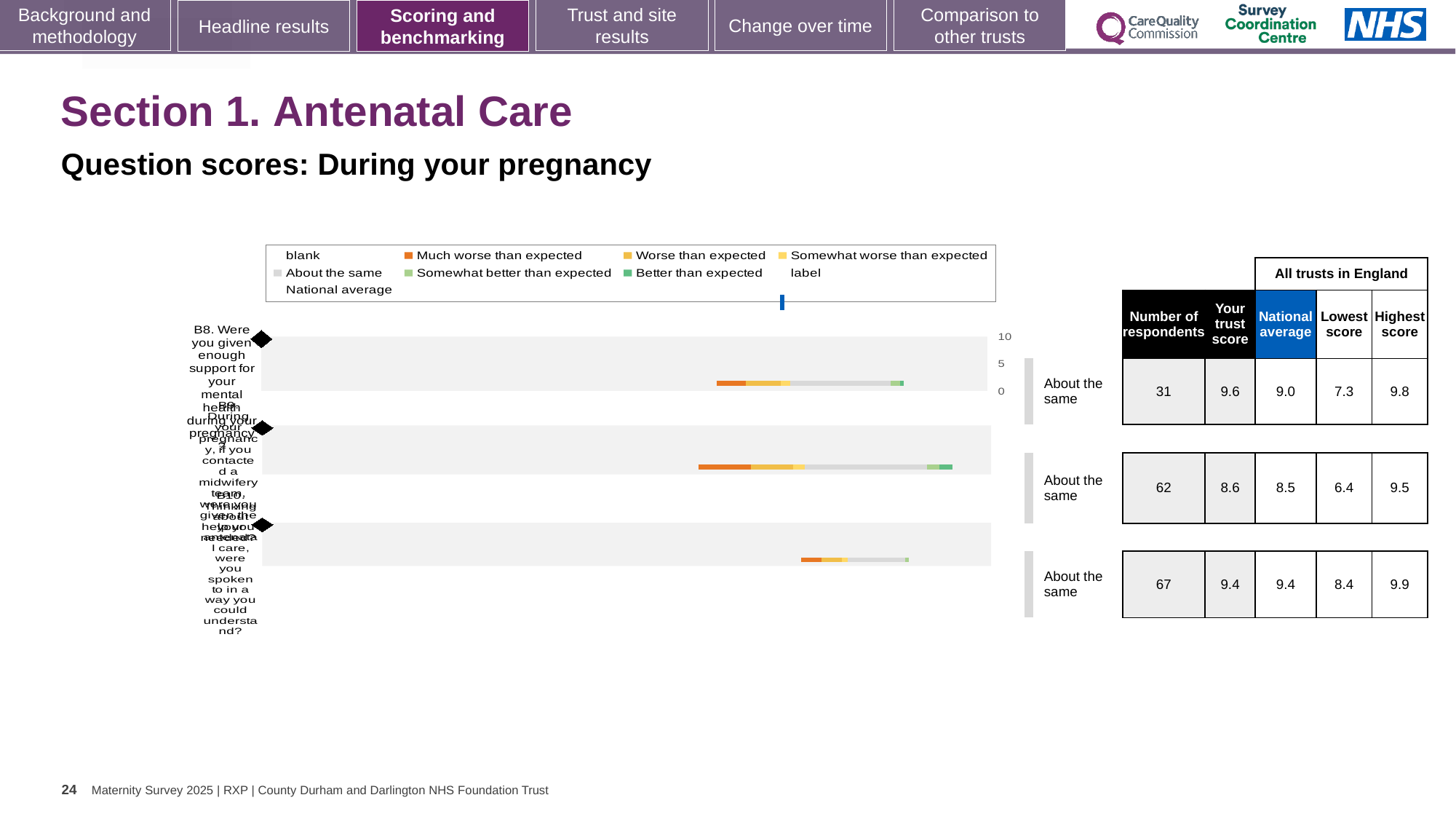
What kind of chart is shown on the slide? bar chart What is the highest score shown for the third (bottom) row? 9.9 Which colour does the legend use for 'Much worse than expected'? orange Which row has the higher trust score, the top row or the middle row? the top row What benchmark category is shown for the top row (B8)? About the same How many question rows are plotted in the chart? 3 What is the national average for the top row (B8)? 9.0 What is the difference between the highest score and the lowest score for the top row (B8)? 2.5 Which row has the largest number of respondents? the third (bottom) row How many respondents are shown for the second (middle) row? 62 What is the trust score for the top row (B8, support for your mental health during pregnancy)? 9.6 What is the lowest score shown for the second (middle) row? 6.4